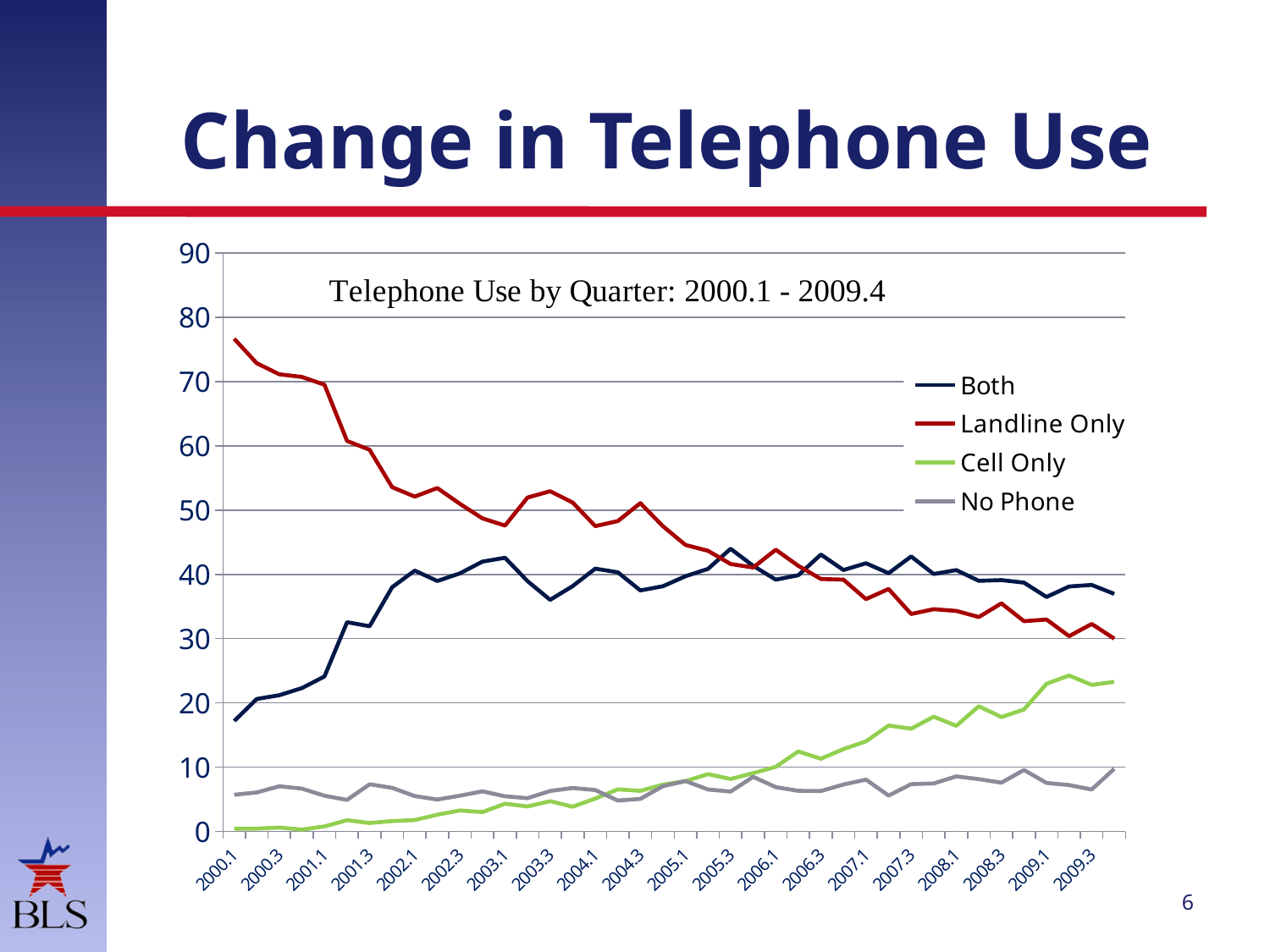
Which series has the highest value at 2009.3? Both Does the Cell Only series rise or fall from 2000.1 to 2009.4? rise Which series is drawn in green? Cell Only Which series has the highest value at 2000.1? Landline Only What is the title printed inside the chart area? Telephone Use by Quarter: 2000.1 - 2009.4 Does the Landline Only series rise or fall from 2000.1 to 2009.4? fall Which series has the lowest value at 2000.1? Cell Only Is the value for Both at 2000.1 greater or less than 20? less What kind of chart is shown on the slide? line chart How many series does the legend list? 4 At 2009.3, which is larger: Cell Only or No Phone? Cell Only Is the value for Landline Only at 2000.1 greater or less than 70? greater